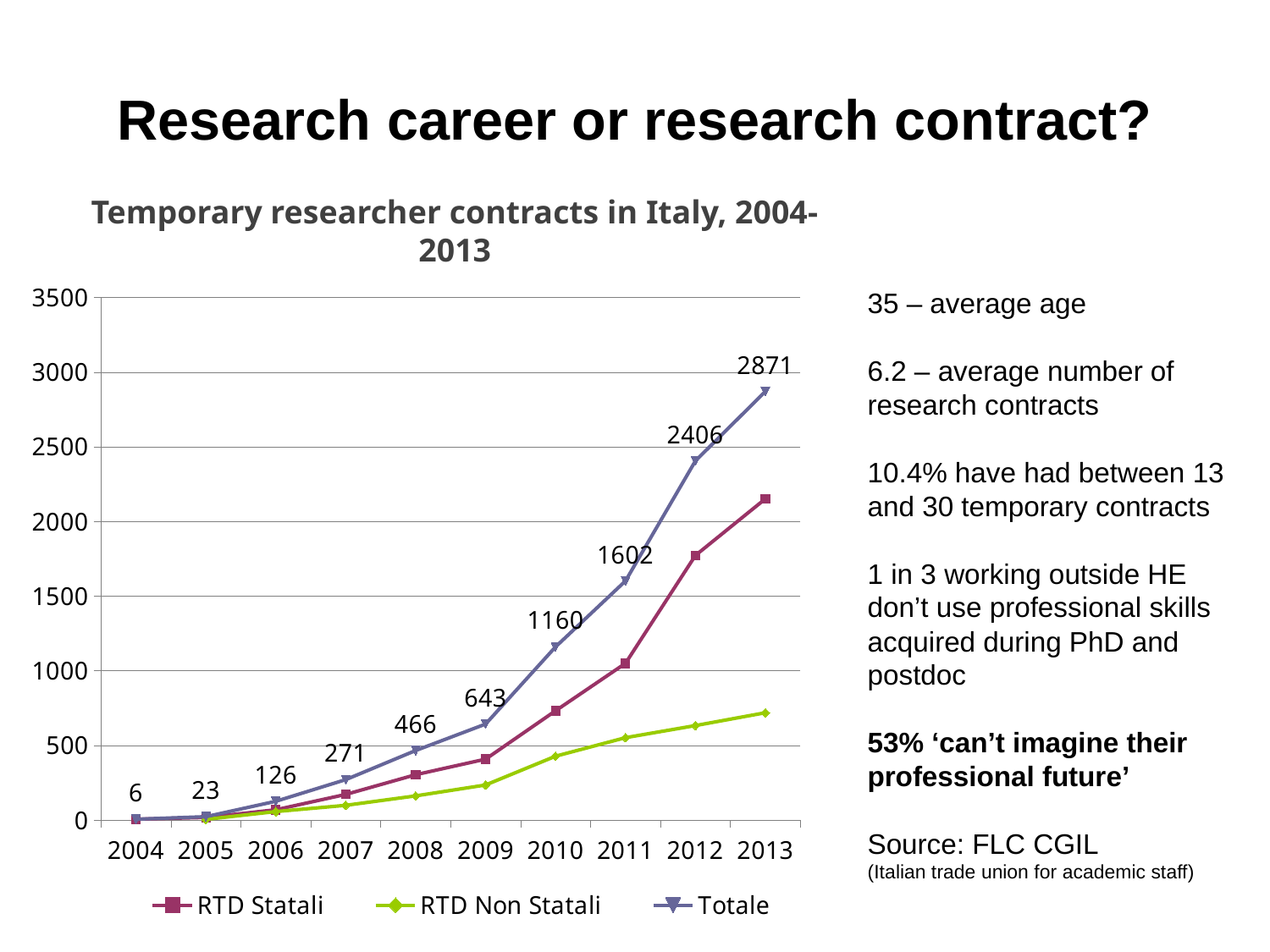
What is the value of the Totale series in 2010? 1160 What kind of chart is shown on the slide? Line chart By how much did the Totale series increase from 2012 to 2013? 465 Is the value for RTD Non Statali in 2013 greater or less than 1000? less How many years are plotted on the x axis? 10 How many series does the legend list? 3 In which year is the Totale series at its lowest? 2004 Which series has the higher value in 2013, RTD Statali or RTD Non Statali? RTD Statali Is the value for RTD Statali in 2013 greater or less than 2000? greater What is the value of the Totale series in 2013? 2871 What is the value of the Totale series in 2007? 271 In which year is the Totale series at its highest? 2013